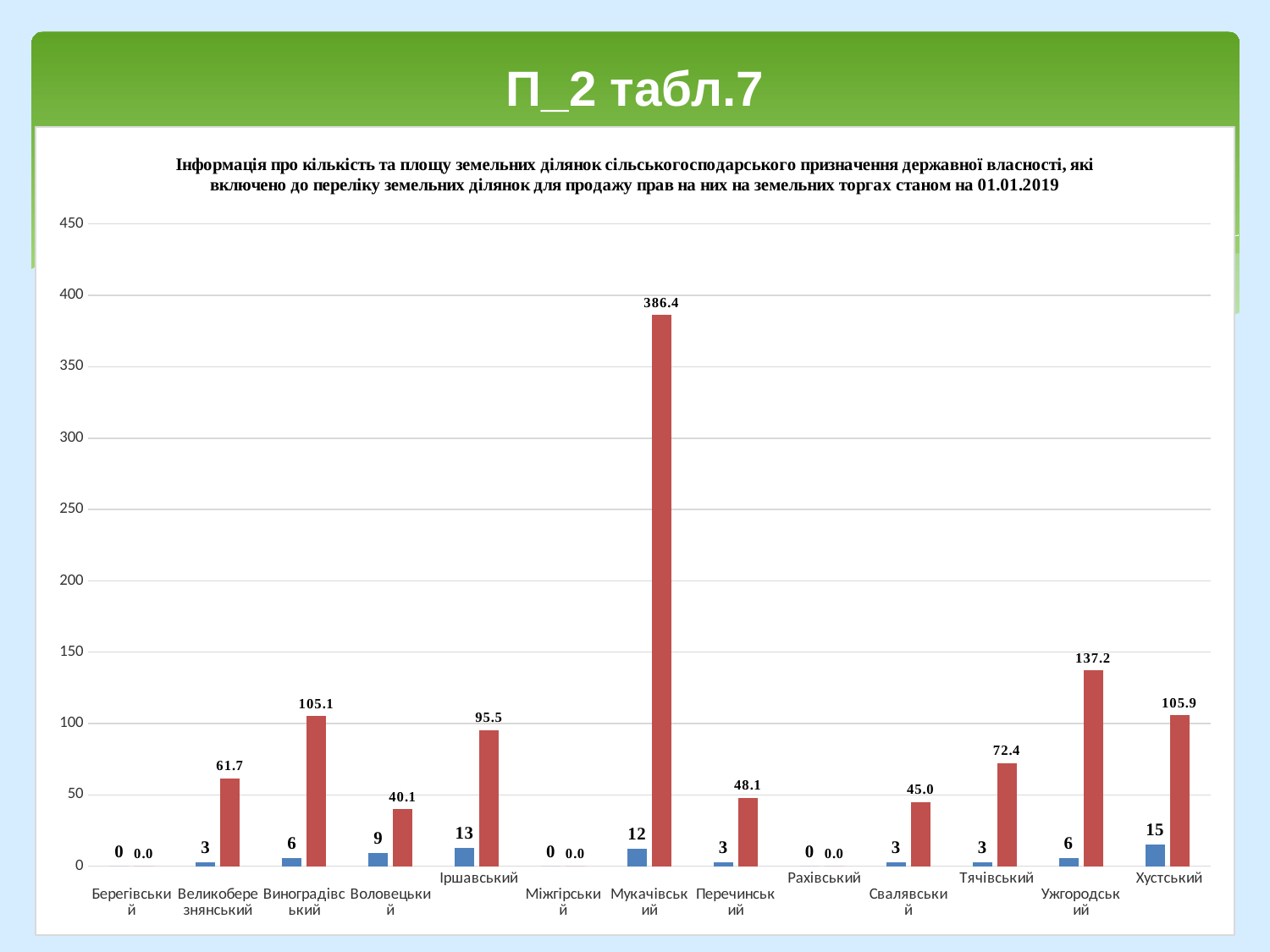
Which category has the highest blue bar? Хустський How many categories have a red bar value of 0.0? 3 Is the red bar value for Мукачівський greater or less than 350? greater What is the value of the blue bar for Іршавський? 13 What is the value of the red bar for Ужгородський? 137.2 What is the value of the red bar for Мукачівський? 386.4 What kind of chart is shown on the slide? Bar chart Which has a larger red bar value, Виноградівський or Іршавський? Виноградівський What is the value of the blue bar for Хустський? 15 What is the difference between the red bar values for Ужгородський and Тячівський? 64.8 How many categories are shown on the x axis? 13 Which category has the highest red bar? Мукачівський